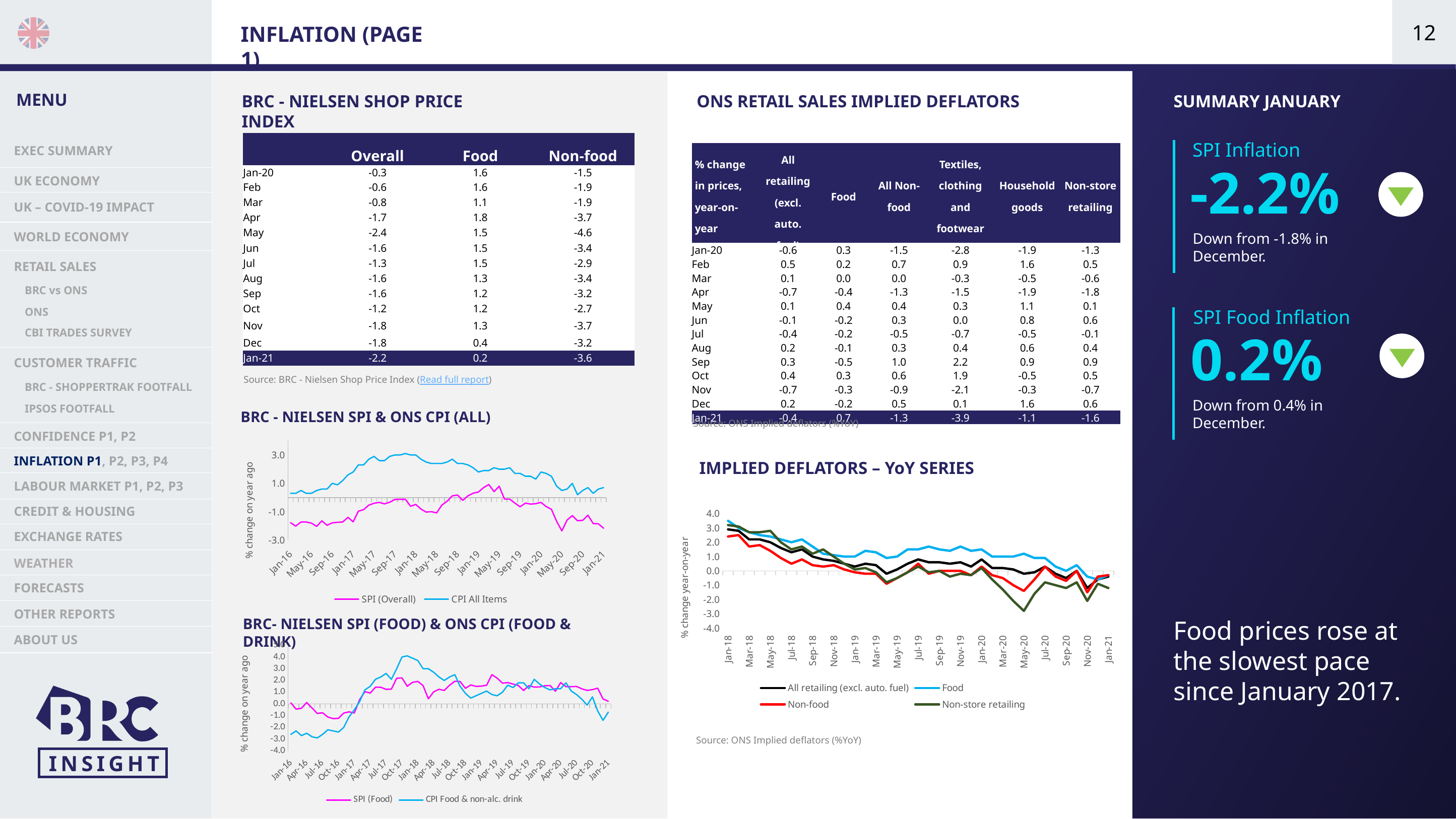
In the 'IMPLIED DEFLATORS – YoY SERIES' chart, which series is lowest at May-20? Non-store retailing In the 'BRC- NIELSEN SPI (FOOD) & ONS CPI (FOOD & DRINK)' chart, is the CPI Food & non-alc. drink value at Jan-18 greater or less than 3.0? greater In the 'BRC - NIELSEN SPI & ONS CPI (ALL)' chart, does the CPI All Items line rise or fall from Jan-18 to Jan-21? Fall What are the two legend entries of the 'BRC- NIELSEN SPI (FOOD) & ONS CPI (FOOD & DRINK)' chart? SPI (Food) and CPI Food & non-alc. drink How many series does the legend of the 'BRC - NIELSEN SPI & ONS CPI (ALL)' chart list? 2 In the 'BRC - NIELSEN SPI & ONS CPI (ALL)' chart, is the CPI All Items value at Jan-18 greater or less than 1.0? greater In the 'BRC - NIELSEN SPI & ONS CPI (ALL)' chart, is the SPI (Overall) value at Jan-16 greater or less than -1.0? less In the 'IMPLIED DEFLATORS – YoY SERIES' chart, does the Food line rise or fall from Jan-18 to Jan-21? Fall What kind of chart is the 'BRC - NIELSEN SPI & ONS CPI (ALL)' chart? Line chart How many series does the legend of the 'IMPLIED DEFLATORS – YoY SERIES' chart list? 4 In the 'BRC - NIELSEN SPI & ONS CPI (ALL)' chart, which series is higher at Jan-18, SPI (Overall) or CPI All Items? CPI All Items